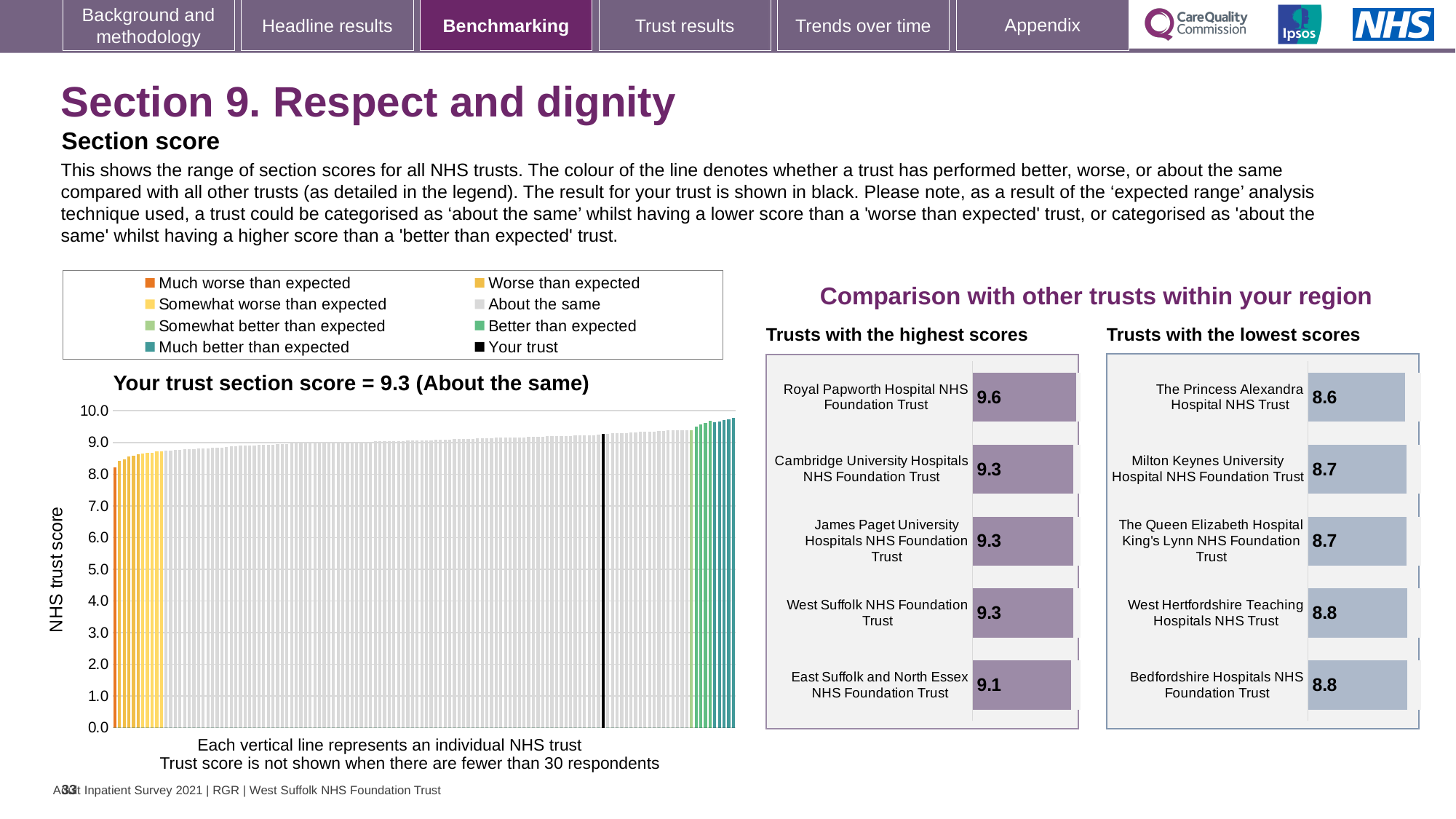
In the 'Trusts with the highest scores' chart, which trust has the highest score? Royal Papworth Hospital NHS Foundation Trust How many trusts are shown in the 'Trusts with the highest scores' chart? 5 In the 'Trusts with the highest scores' chart, what is the score for East Suffolk and North Essex NHS Foundation Trust? 9.1 In the 'Trusts with the lowest scores' chart, which trust has the lowest score? The Princess Alexandra Hospital NHS Trust In the 'Trusts with the lowest scores' chart, what is the score for The Princess Alexandra Hospital NHS Trust? 8.6 In the 'Trusts with the highest scores' chart, what is the difference between the scores of Royal Papworth Hospital NHS Foundation Trust and East Suffolk and North Essex NHS Foundation Trust? 0.5 In the 'Trusts with the lowest scores' chart, what is the score for Bedfordshire Hospitals NHS Foundation Trust? 8.8 How many entries does the legend above the 'Your trust section score' chart list? 8 In the 'Trusts with the lowest scores' chart, which has the larger score: West Hertfordshire Teaching Hospitals NHS Trust or Milton Keynes University Hospital NHS Foundation Trust? West Hertfordshire Teaching Hospitals NHS Trust In the 'Trusts with the highest scores' chart, what is the score for Royal Papworth Hospital NHS Foundation Trust? 9.6 What kind of chart is the 'Your trust section score' chart on the left? Bar chart In the 'Your trust section score' chart, do the bar values rise or fall from left to right? Rise